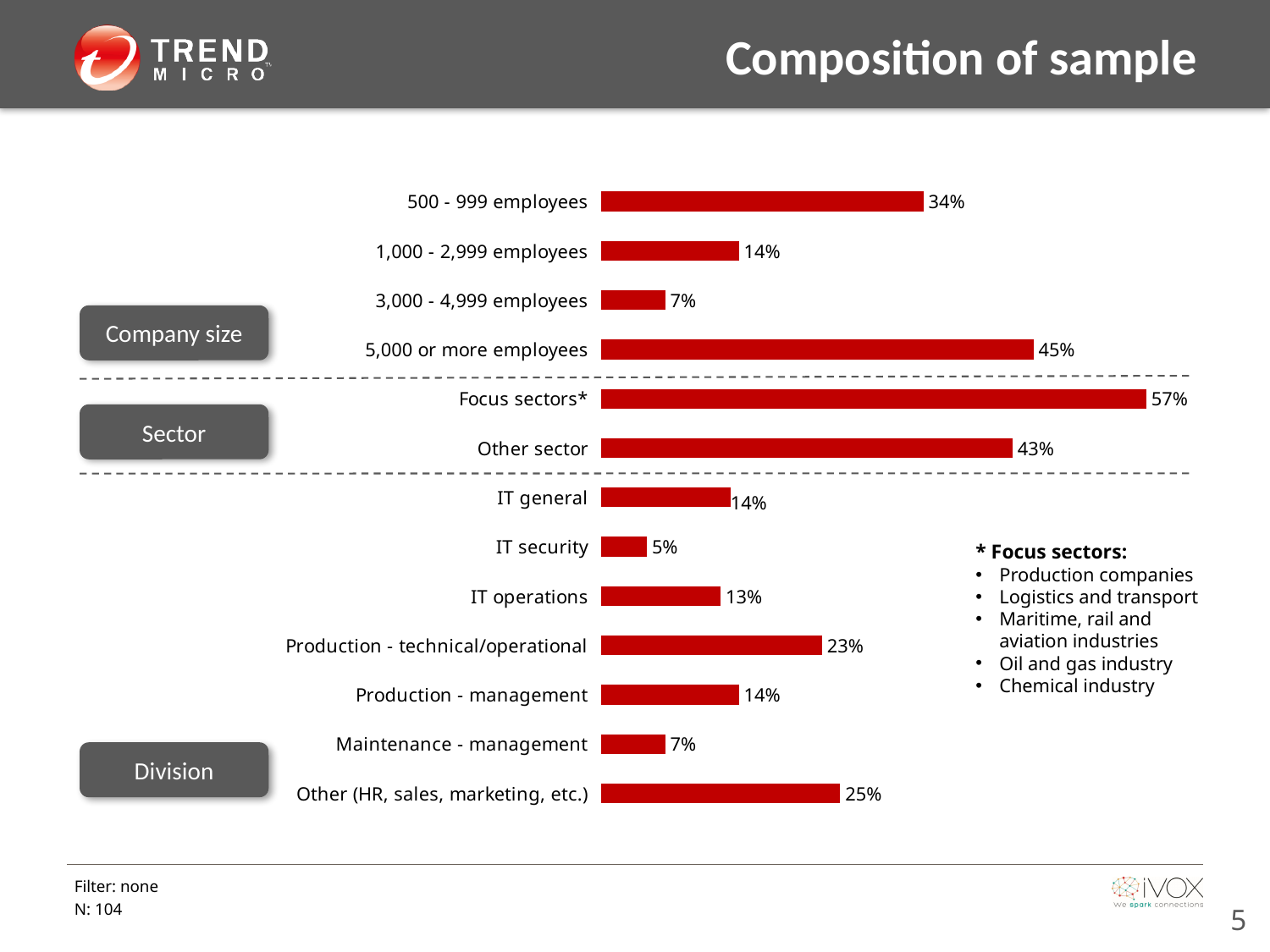
Which company size category has the highest share of the sample? 5,000 or more employees What is the value for Production - technical/operational? 23% What percentage of respondents are in IT security? 5% What is the combined share of IT general, IT security and IT operations? 32% Which is larger: the share for 500 - 999 employees or for 1,000 - 2,999 employees? 500 - 999 employees What type of chart is shown on the slide? Bar chart Which division has the lowest share of the sample? IT security What is the difference between Focus sectors and Other sector? 14% How many division categories are shown in the chart? 7 What is the title of the slide? Composition of sample What is the value for Focus sectors? 57% What percentage of the sample is from companies with 5,000 or more employees? 45%